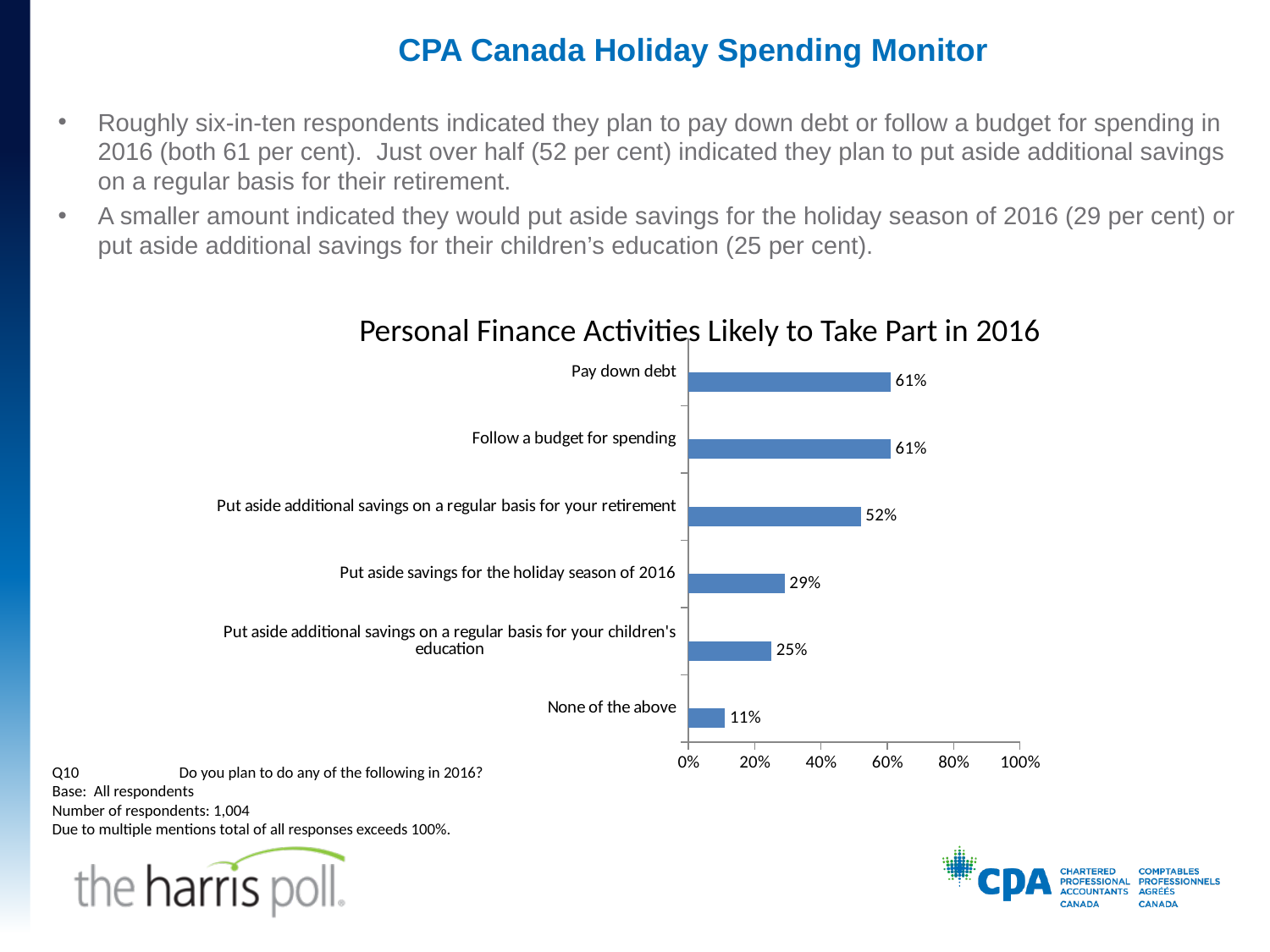
What is the difference between "Put aside savings for the holiday season of 2016" and "None of the above"? 18% Is the value for "Pay down debt" greater or less than 40%? greater What is the value for "Put aside additional savings on a regular basis for your retirement"? 52% What is the value for "Put aside savings for the holiday season of 2016"? 29% What is the value for "Pay down debt"? 61% What is the difference between "Follow a budget for spending" and "Put aside additional savings on a regular basis for your children's education"? 36% What kind of chart is shown on the slide? Bar chart Which is larger: the value for "Put aside additional savings on a regular basis for your retirement" or the value for "Put aside savings for the holiday season of 2016"? Put aside additional savings on a regular basis for your retirement How many categories are shown in the chart? 6 Which category has the lowest value? None of the above What is the title of the chart? Personal Finance Activities Likely to Take Part in 2016 What is the value for "None of the above"? 11%